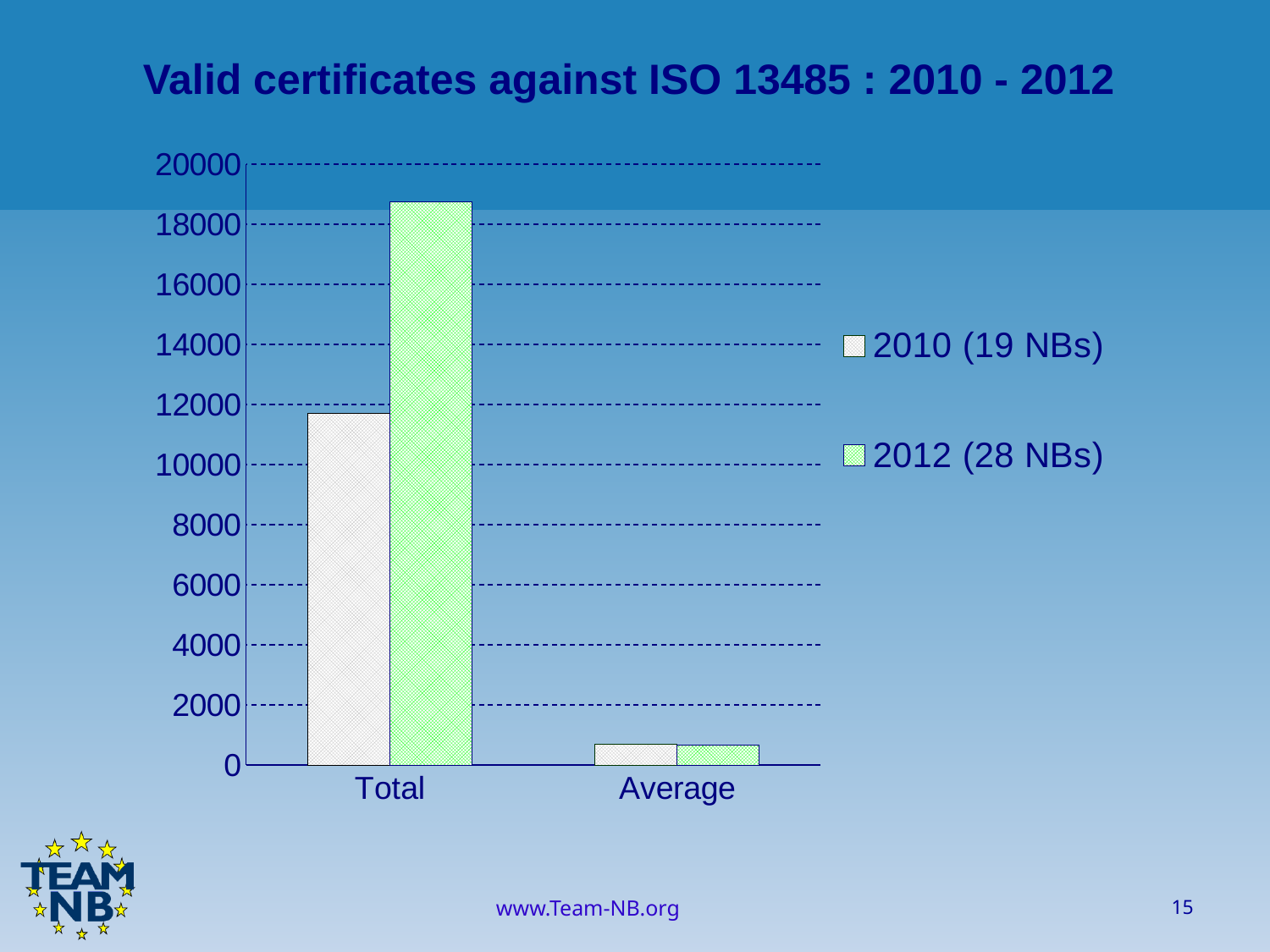
Is the Total value for 2012 (28 NBs) greater or less than 18000? greater How many categories are shown on the x axis? 2 Is the Total value for 2010 (19 NBs) greater or less than 12000? less What are the two legend entries? 2010 (19 NBs) and 2012 (28 NBs) Is the Average value for 2012 (28 NBs) greater or less than 2000? less Which category has the lowest value for the 2010 (19 NBs) series? Average What kind of chart is shown on the slide? bar chart Which category has the highest value for the 2012 (28 NBs) series? Total For the Total category, which series has the larger value, 2010 (19 NBs) or 2012 (28 NBs)? 2012 (28 NBs) How many series does the legend list? 2 What is the title of the chart? Valid certificates against ISO 13485 : 2010 - 2012